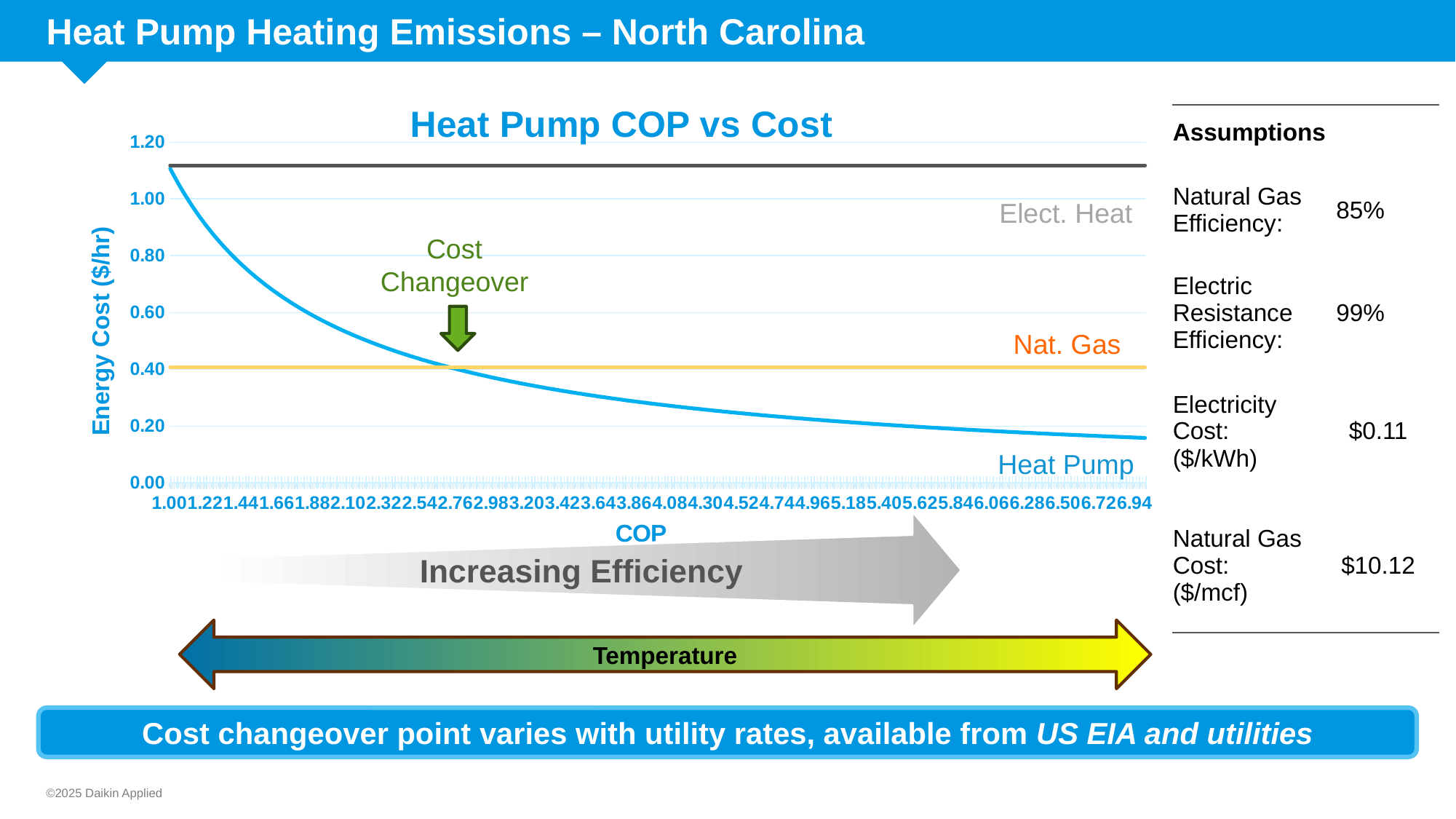
Does the Heat Pump line rise or fall as COP increases along the x axis? fall Is the energy cost for Nat. Gas greater or less than 0.60? less Which series has the highest energy cost across the chart? Elect. Heat Is the Heat Pump energy cost at COP 1.00 greater or less than 1.00? greater Is the Heat Pump energy cost at COP 6.94 greater or less than 0.20? less What kind of chart is shown on the slide? line chart Which series has the lowest energy cost at the right end of the chart (COP 6.94)? Heat Pump Which is larger, the energy cost for Elect. Heat or for Nat. Gas? Elect. Heat How many series are plotted on the chart? 3 What is the label of the vertical axis? Energy Cost ($/hr) What is the title of the chart? Heat Pump COP vs Cost